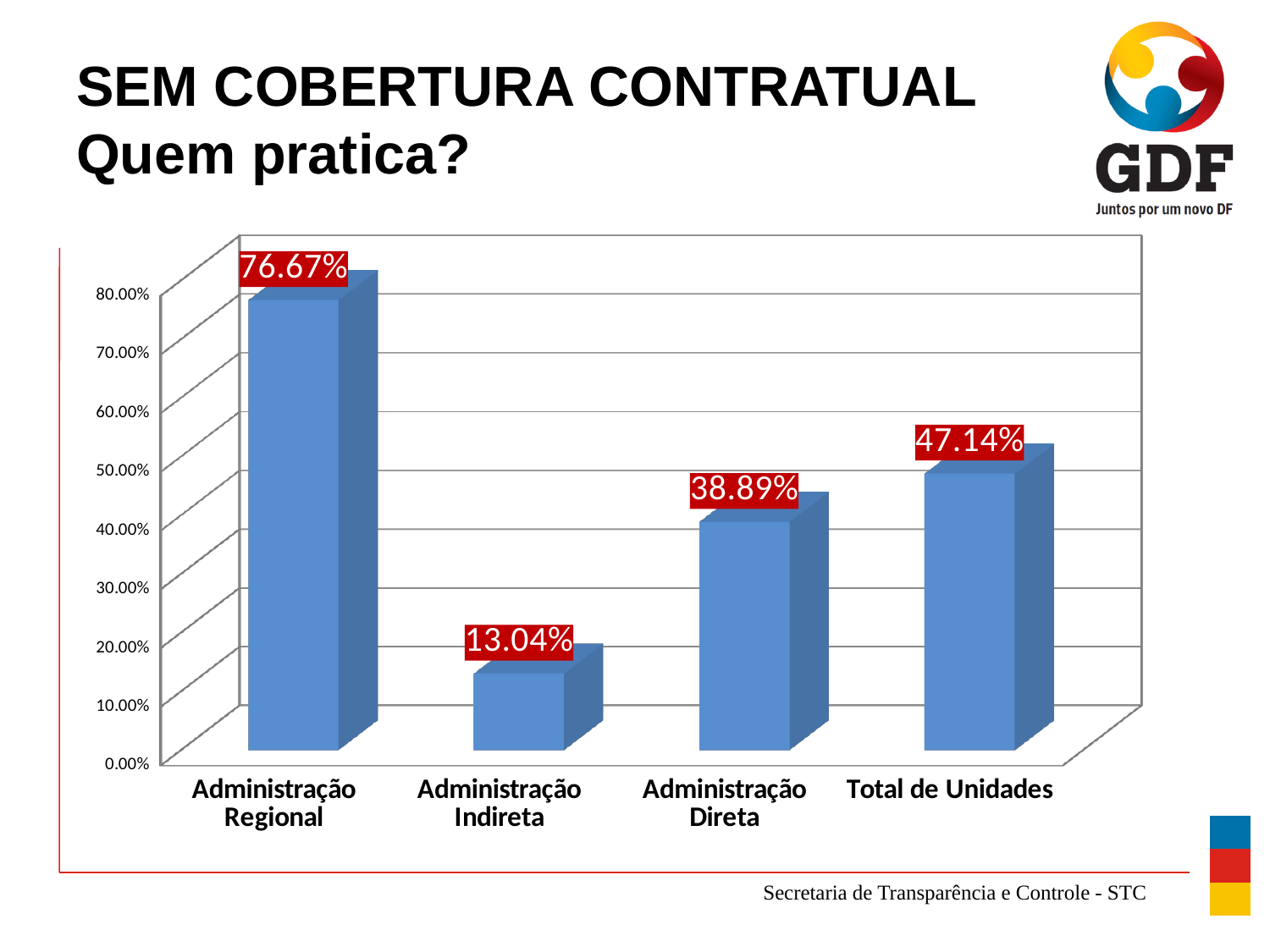
Is the value for Administração Direta greater or less than 40.00%? less Which is larger, the value for Administração Direta or the value for Total de Unidades? Total de Unidades How many categories are shown on the chart? 4 Which category has the lowest value? Administração Indireta What kind of chart is shown on the slide? bar chart What is the difference between the values for Administração Regional and Administração Indireta? 63.63% What is the value for Administração Regional? 76.67% What is the difference between the values for Total de Unidades and Administração Direta? 8.25% What is the value for Total de Unidades? 47.14% What is the value for Administração Direta? 38.89% What is the value for Administração Indireta? 13.04% Which category has the highest value? Administração Regional